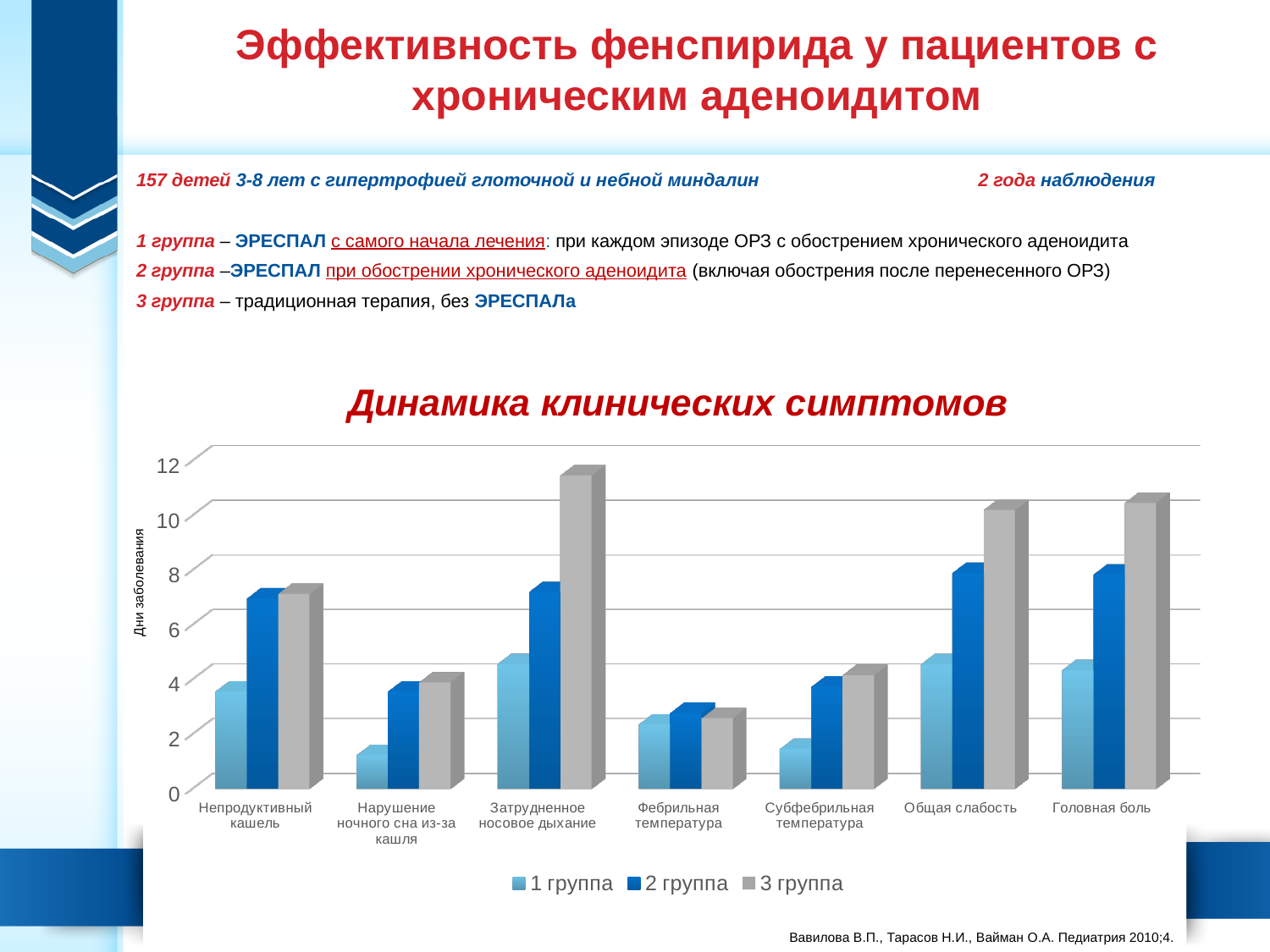
How many symptom categories are shown on the x axis of the chart? 7 For which category is the 3 группа bar the highest? Затрудненное носовое дыхание What is the label of the vertical axis of the chart? Дни заболевания Is the value for 2 группа in the category "Общая слабость" greater or less than 6? greater Which series is shown in grey in the chart legend? 3 группа How many series does the chart legend list? 3 Is the value for 3 группа in the category "Головная боль" greater or less than 8? greater Is the value for 3 группа in the category "Затрудненное носовое дыхание" greater or less than 10? greater For 2 группа, which is larger: the value for "Затрудненное носовое дыхание" or for "Фебрильная температура"? Затрудненное носовое дыхание What kind of chart is shown under the title "Динамика клинических симптомов"? bar chart In the category "Общая слабость", which is larger: the value for 1 группа or for 3 группа? 3 группа